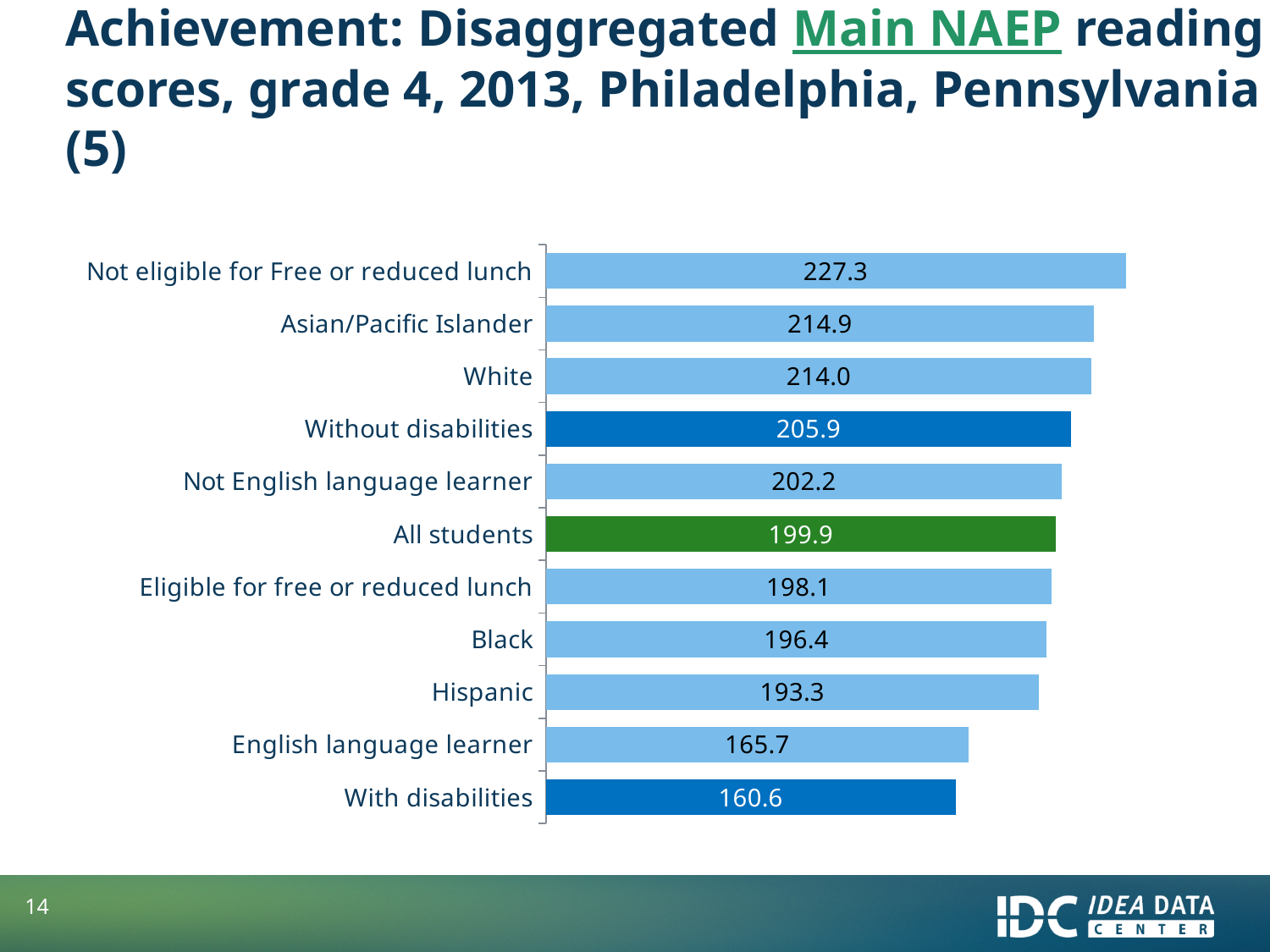
What kind of chart is shown on the slide? Bar chart What is the difference between the scores for Without disabilities and With disabilities? 45.3 Which has a higher reading score, Asian/Pacific Islander or White students? Asian/Pacific Islander What is the reading score for All students? 199.9 What is the reading score for English language learner students? 165.7 Which has a higher reading score, Black students or Hispanic students? Black Which category has the highest reading score? Not eligible for Free or reduced lunch What is the reading score for students With disabilities? 160.6 What is the reading score for Hispanic students? 193.3 How many categories are shown in the chart? 11 What is the difference between the scores for Not eligible for Free or reduced lunch and Eligible for free or reduced lunch? 29.2 Which category has the lowest reading score? With disabilities